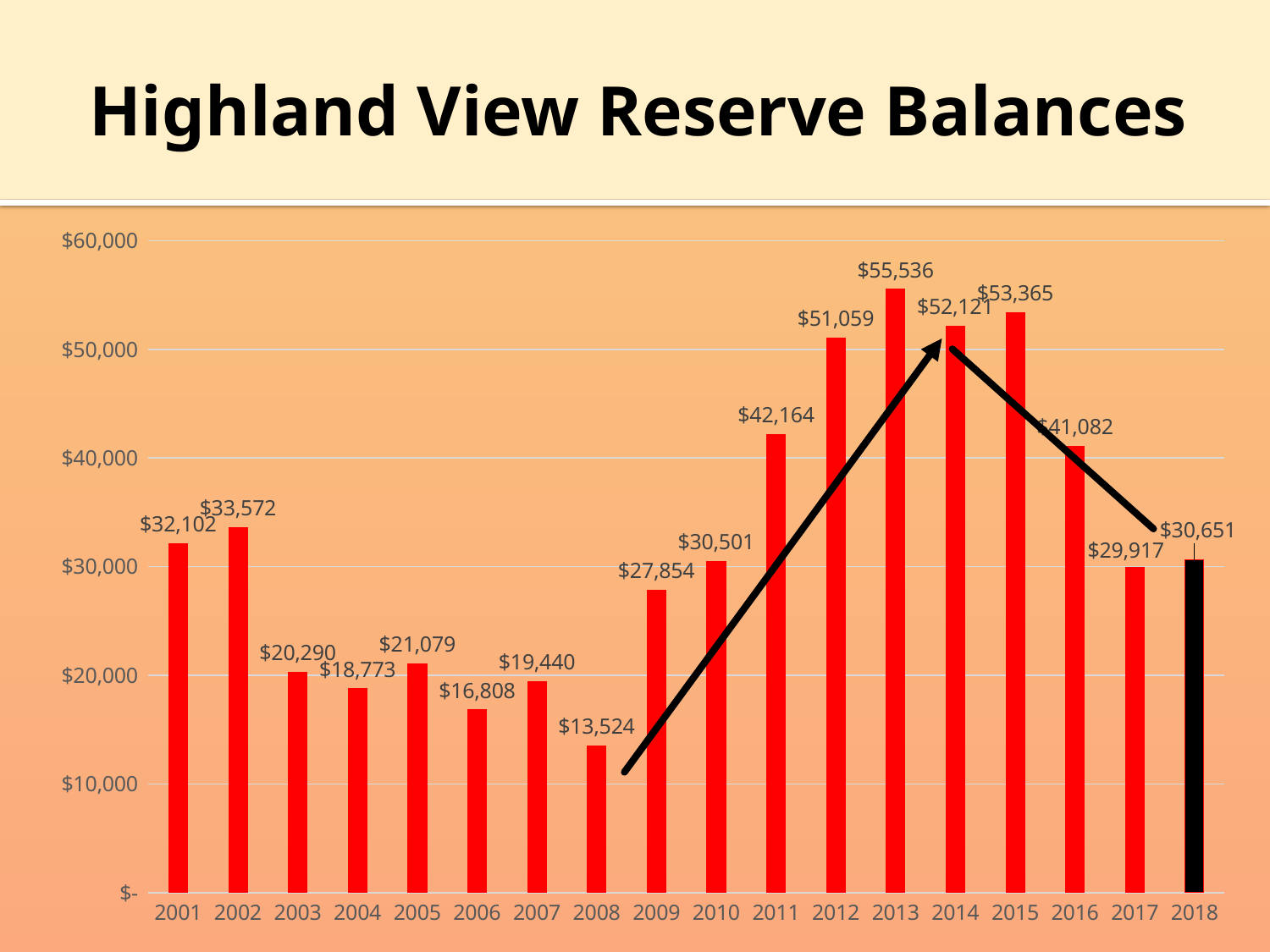
What is the reserve balance for 2013? $55,536 What kind of chart is shown on the slide? Bar chart Is the reserve balance for 2011 greater or less than $40,000? greater What is the difference between the 2013 and 2008 reserve balances? $42,012 What is the reserve balance for 2008? $13,524 Which year has a larger reserve balance, 2012 or 2016? 2012 What is the difference between the 2018 and 2017 reserve balances? $734 How many years are shown on the x axis? 18 What is the reserve balance for 2018? $30,651 Which year has the highest reserve balance? 2013 Do the reserve balances rise or fall from 2008 to 2013? Rise Which year has the lowest reserve balance? 2008